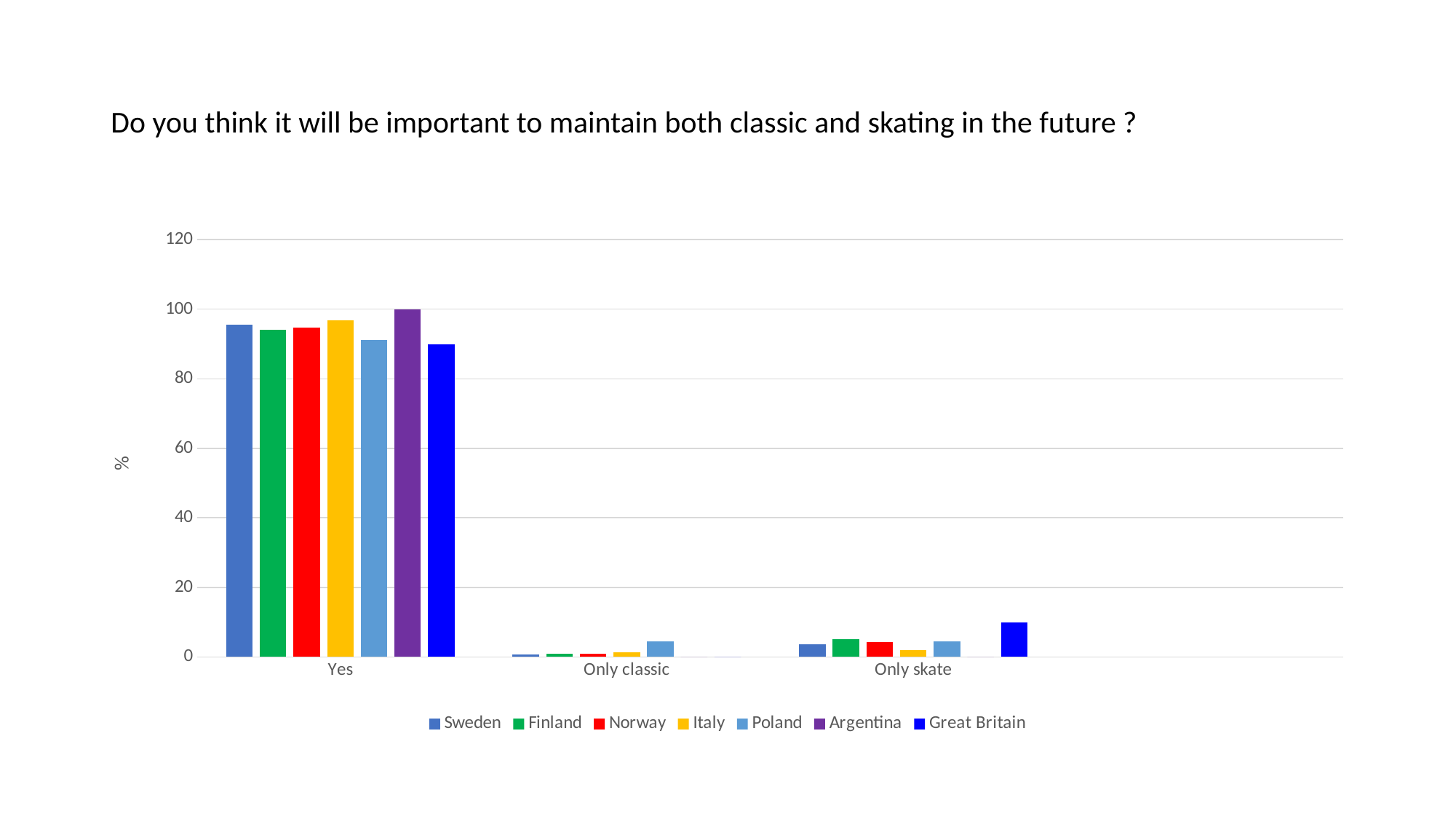
Is the value for Great Britain in the Yes category greater or less than 80? greater What is the label on the vertical axis? % What kind of chart is shown on the slide? bar chart In the Only skate category, which is larger: the value for Great Britain or the value for Poland? Great Britain What is the value for Argentina in the Yes category? 100 Which country has the highest value in the Only classic category? Poland In the Yes category, which is larger: the value for Argentina or the value for Great Britain? Argentina Which country has the highest value in the Only skate category? Great Britain Is the value for Great Britain in the Only skate category greater or less than 20? less Which country has the highest value in the Yes category? Argentina How many answer categories are shown on the x axis? 3 How many series does the legend list? 7